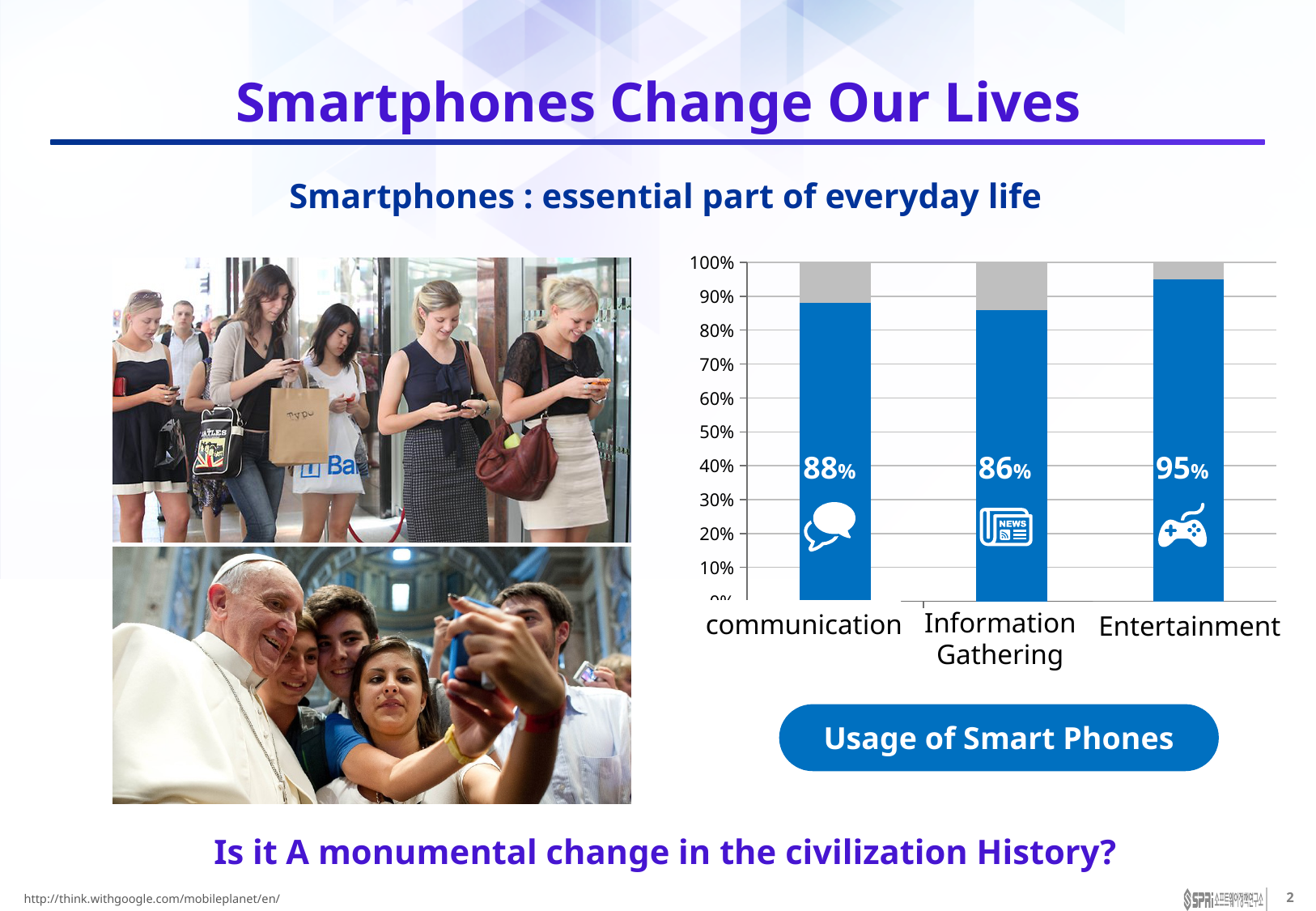
What percentage is shown for Entertainment in the Usage of Smart Phones chart? 95% Which category has the highest usage percentage in the chart? Entertainment Which category has the lowest usage percentage in the chart? Information Gathering Is the value for Information Gathering greater or less than 90%? less What is the difference in percentage points between Entertainment and communication? 7 How many categories are shown on the x axis of the chart? 3 What is the difference in percentage points between communication and Information Gathering? 2 What percentage is shown for communication in the Usage of Smart Phones chart? 88% Which is larger, the value for Entertainment or the value for Information Gathering? Entertainment What kind of chart is used to show the usage of smart phones? bar chart What is the title shown in the box below the chart? Usage of Smart Phones What percentage is shown for Information Gathering in the Usage of Smart Phones chart? 86%